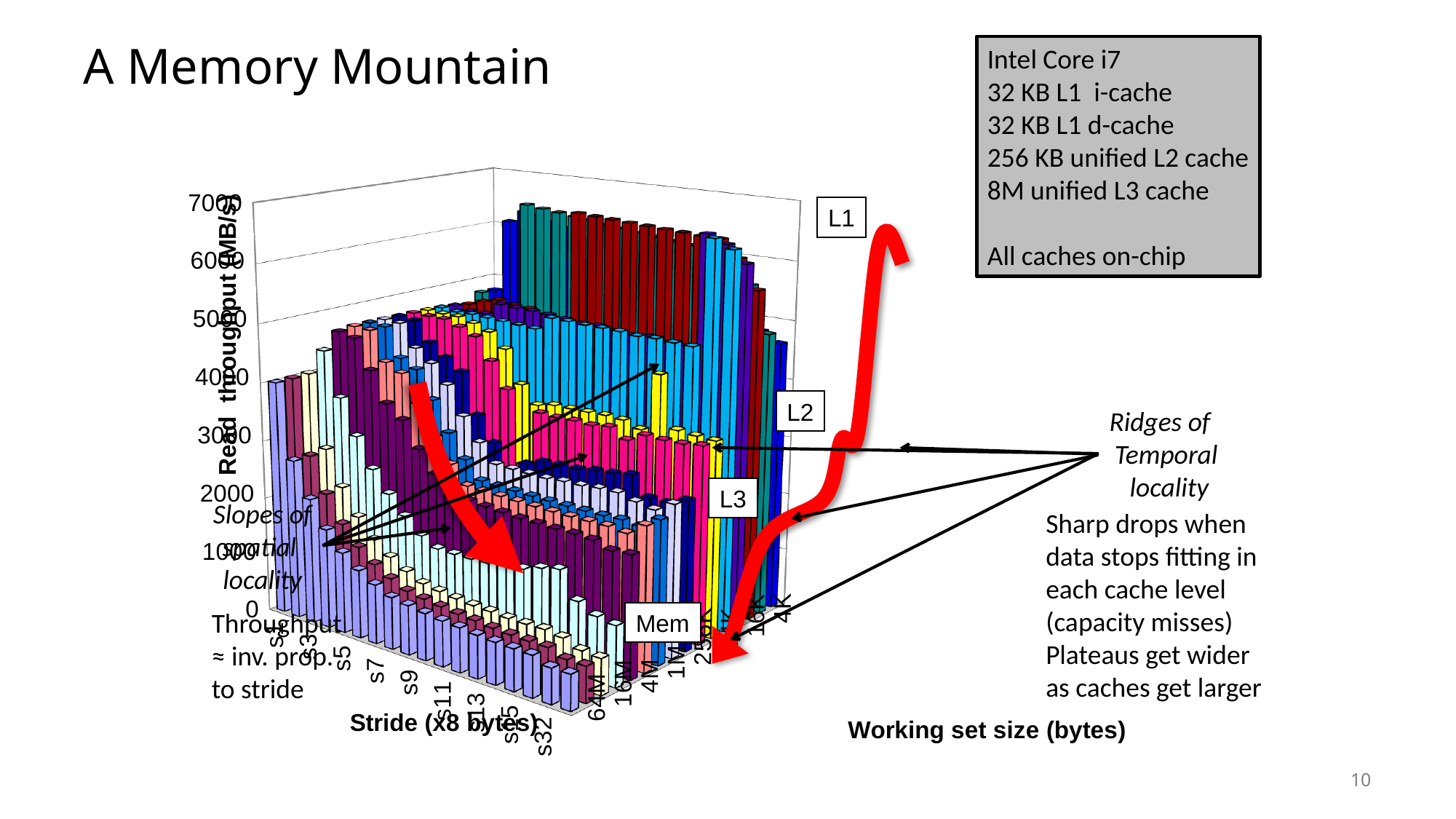
What is the highest tick value shown on the read throughput axis? 7000 How many stride labels are shown along the stride axis? 9 What kind of chart is shown on the slide? 3D bar chart How many working set size labels are shown along the working set size axis? 8 As the working set size increases from 4K to 64M for a fixed stride, does read throughput rise or fall? fall Is the read throughput for stride s32 with a 64M working set greater or less than 2000? less Which has the higher read throughput: stride s1 with a 4K working set, or stride s32 with a 64M working set? stride s1 with a 4K working set Is the read throughput for stride s1 with a 64M working set greater or less than 2000? greater What is the label of the vertical axis of the chart? Read throughput (MB/s)